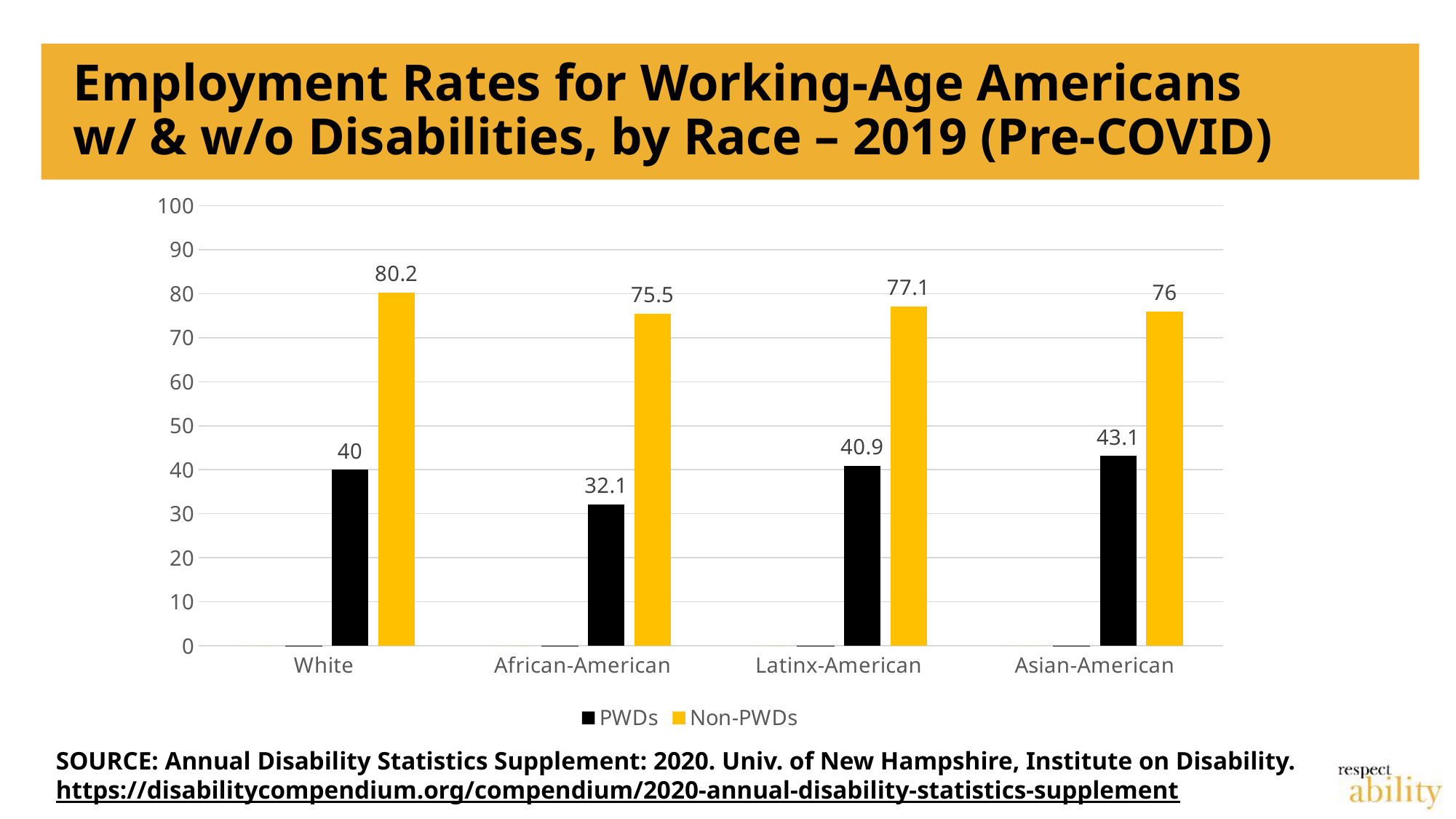
Which is larger, the PWDs employment rate for Asian-American or for Latinx-American? Asian-American How many race categories are shown on the x axis? 4 What is the employment rate for PWDs in the White category? 40 What kind of chart is shown on the slide? Bar chart What is the employment rate for PWDs in the Latinx-American category? 40.9 Which race category has the highest Non-PWDs employment rate? White Which race category has the lowest PWDs employment rate? African-American How many series does the legend list? 2 What is the difference between the Non-PWDs and PWDs employment rates for the White category? 40.2 What is the employment rate for Non-PWDs in the African-American category? 75.5 What colour are the Non-PWDs bars? Yellow What is the employment rate for Non-PWDs in the Asian-American category? 76